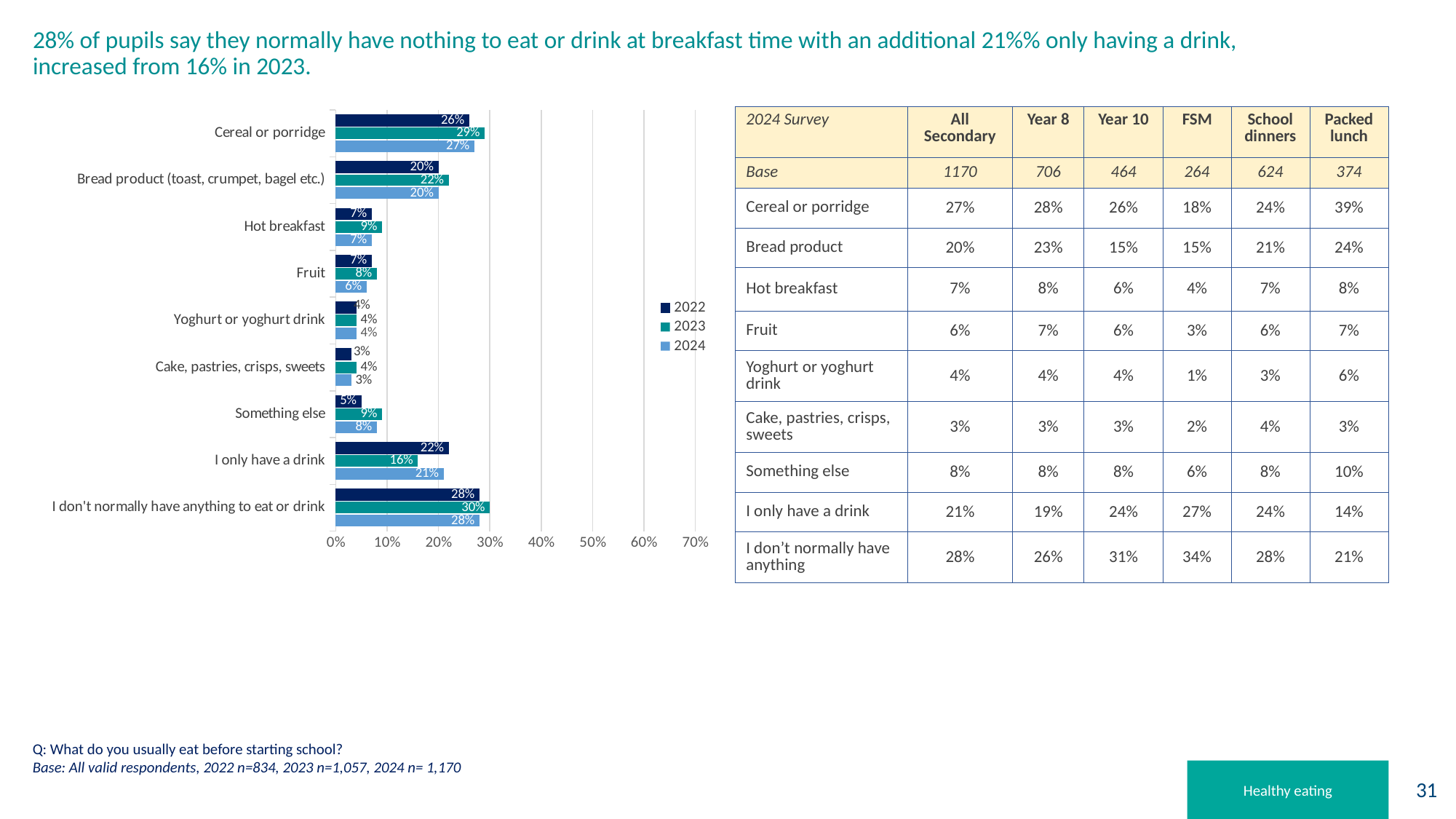
Which legend entry is shown in the darkest colour? 2022 What kind of chart is shown on the slide? bar chart What is the 2023 value for Cereal or porridge? 29% How many series does the chart legend list? 3 What is the 2024 value for I only have a drink? 21% Which is larger, the 2023 value for Hot breakfast or the 2023 value for Fruit? Hot breakfast How many categories are plotted on the chart? 9 Is the 2023 value for I don't normally have anything to eat or drink greater or less than 20%? greater What is the difference between the 2022 and 2023 values for I only have a drink? 6% Which category has the lowest 2022 value? Cake, pastries, crisps, sweets What is the 2022 value for Something else? 5% Which category has the highest 2024 value? I don't normally have anything to eat or drink